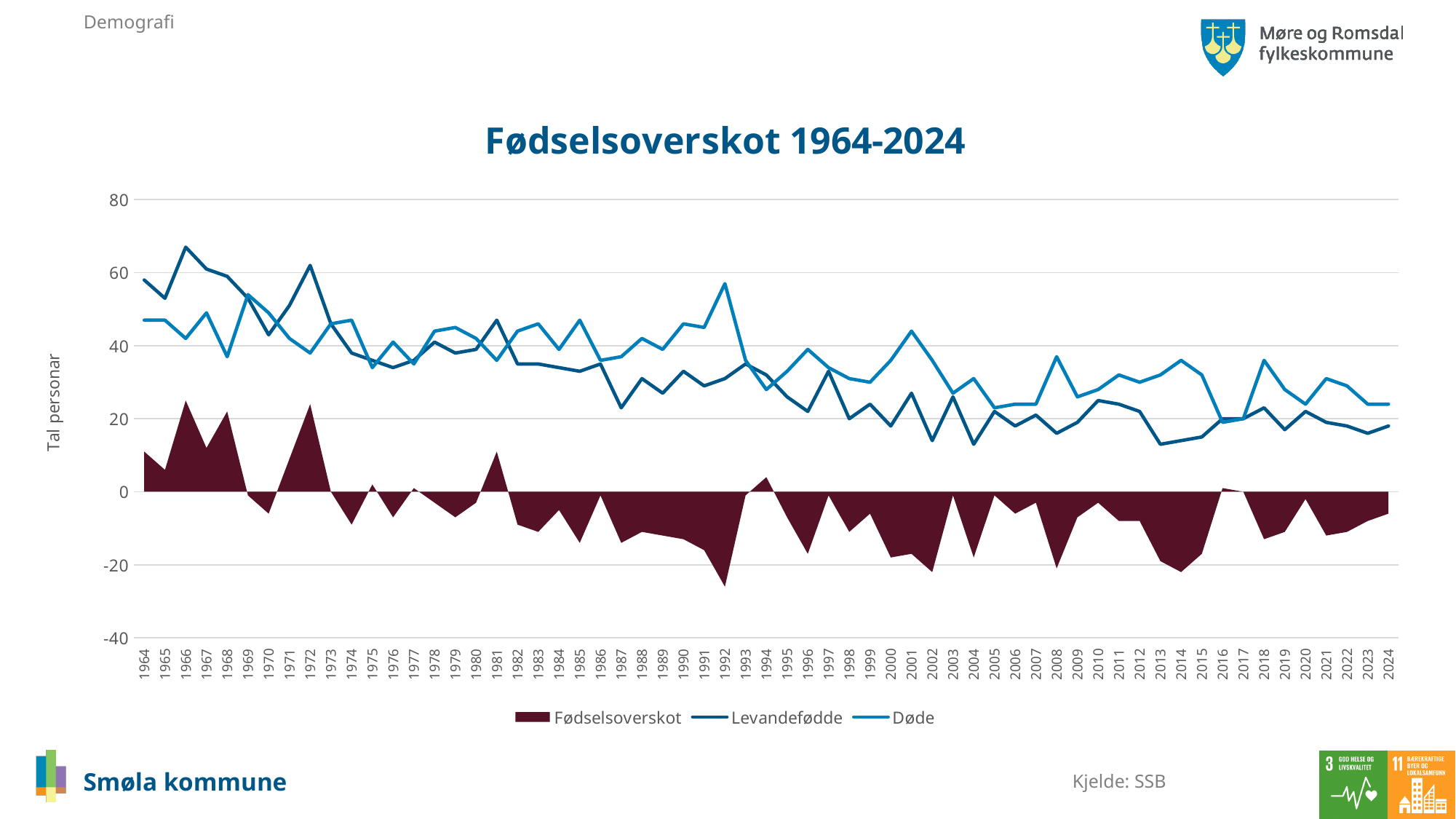
How many series does the legend list? 3 In which year does Levandefødde reach its highest value? 1966 In 1964, which is larger: Levandefødde or Døde? Levandefødde Is the value for Fødselsoverskot in 1992 greater or less than -20? less What is the label on the vertical axis? Tal personar How many years are shown along the x axis? 61 Is the value for Døde in 1992 greater or less than 40? greater What is the title of the chart? Fødselsoverskot 1964-2024 Is the value for Levandefødde in 2013 greater or less than 20? less What kind of chart is used to show the Levandefødde and Døde series? Line chart Does the Levandefødde series generally rise or fall from 1964 to 2024? Fall